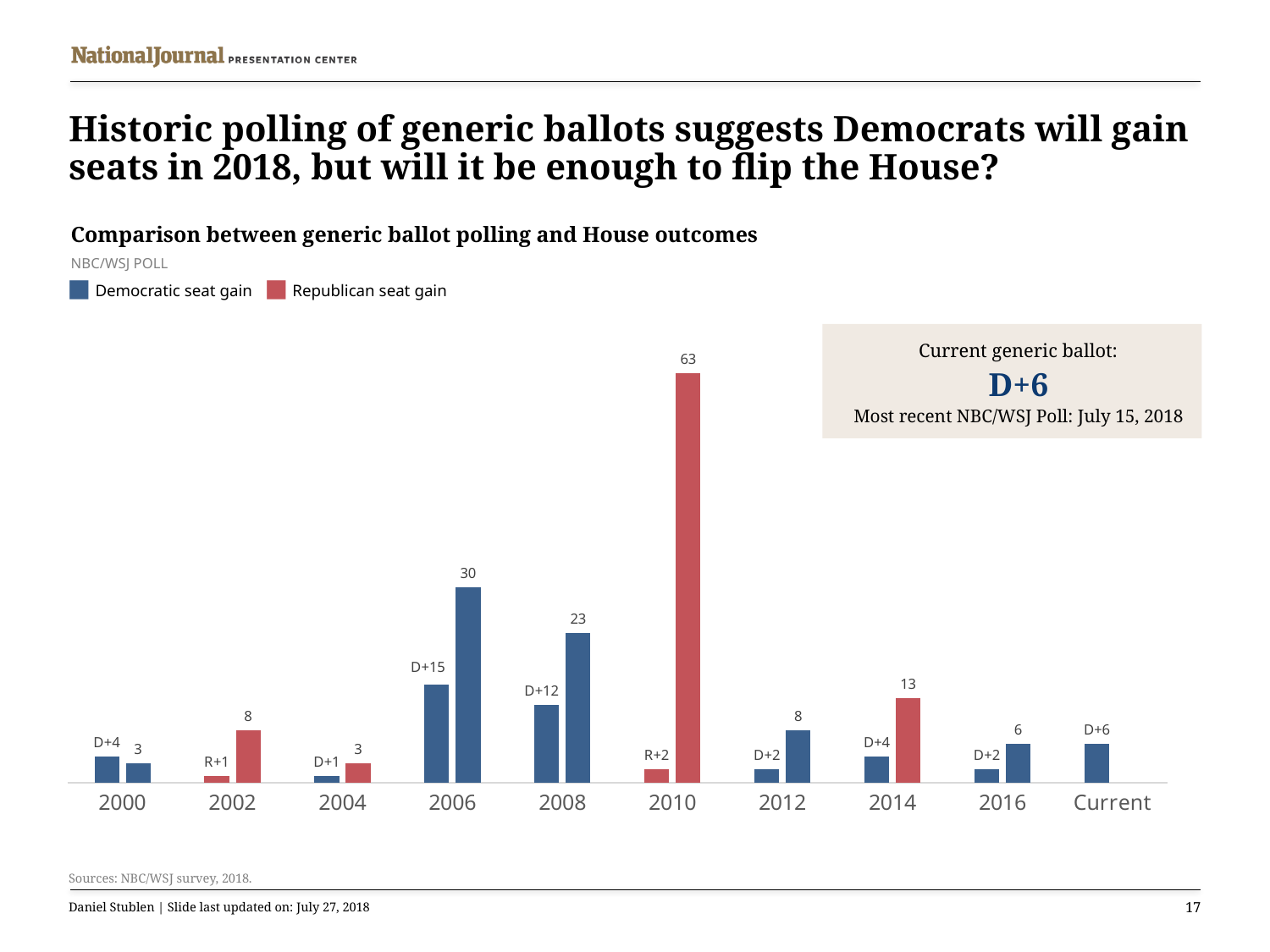
What was the generic ballot polling value for 2006? D+15 How many categories are shown on the x axis? 10 Which year had the largest seat gain? 2010 Which legend entry is shown in red? Republican seat gain What was the seat gain in 2010? 63 What is the difference between the seat gain in 2006 and the seat gain in 2008? 7 What kind of chart is shown on the slide? Bar chart What was the seat gain in 2014? 13 What is the generic ballot polling value for 2010? R+2 What is the generic ballot polling value shown for the Current category? D+6 How many series does the legend list? 2 Which was larger, the seat gain in 2012 or the seat gain in 2014? 2014